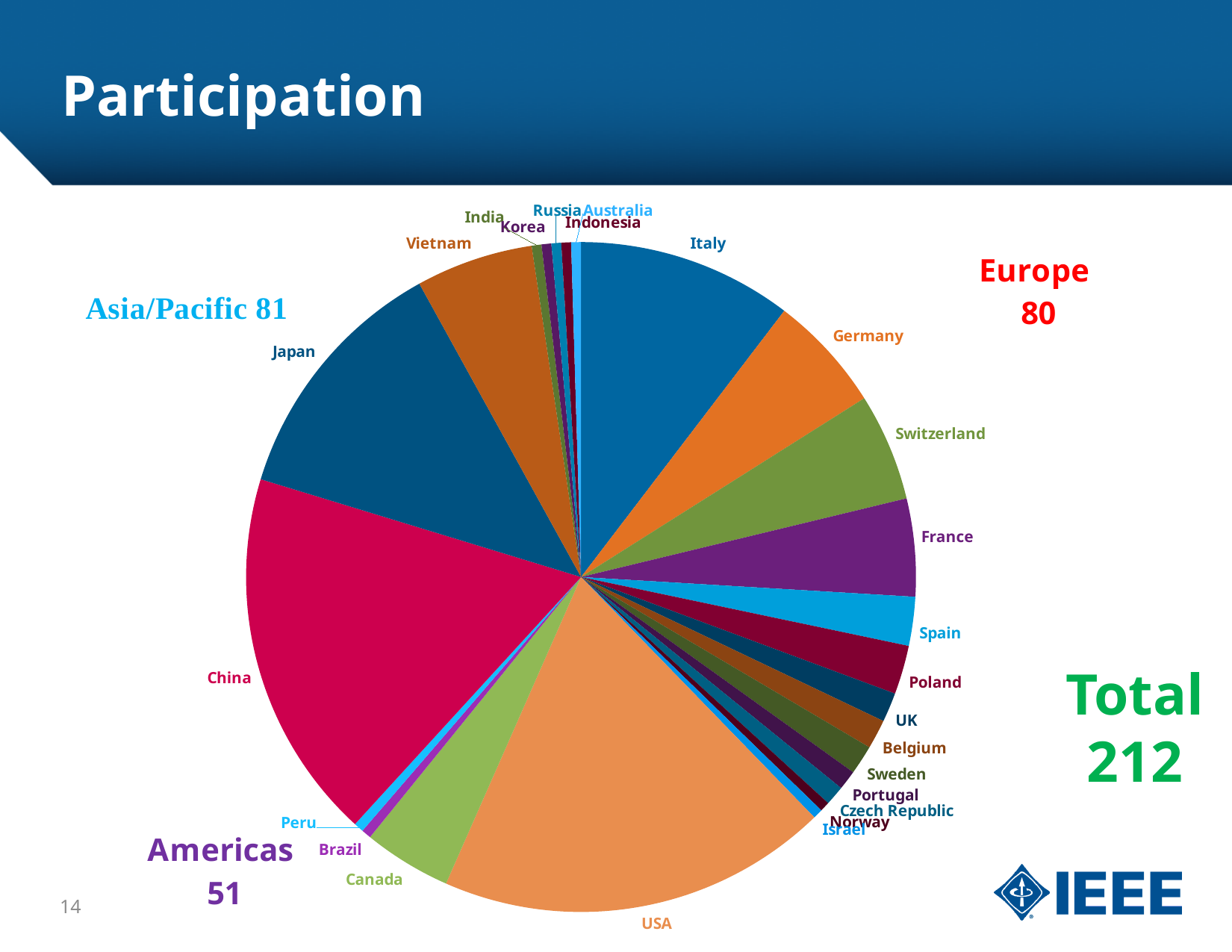
What is the title of the slide containing the pie chart? Participation Which country has the largest slice of the pie chart? USA How many countries are labelled on the pie chart? 25 Which slice is larger, China or Japan? China What participation figure is shown for Europe? 80 What participation figure is shown for Asia/Pacific? 81 What kind of chart is shown on the slide? pie chart What is the total participation shown on the slide? 212 What participation figure is shown for the Americas? 51 Which slice is larger, Italy or Germany? Italy Which slice is larger, France or Spain? France